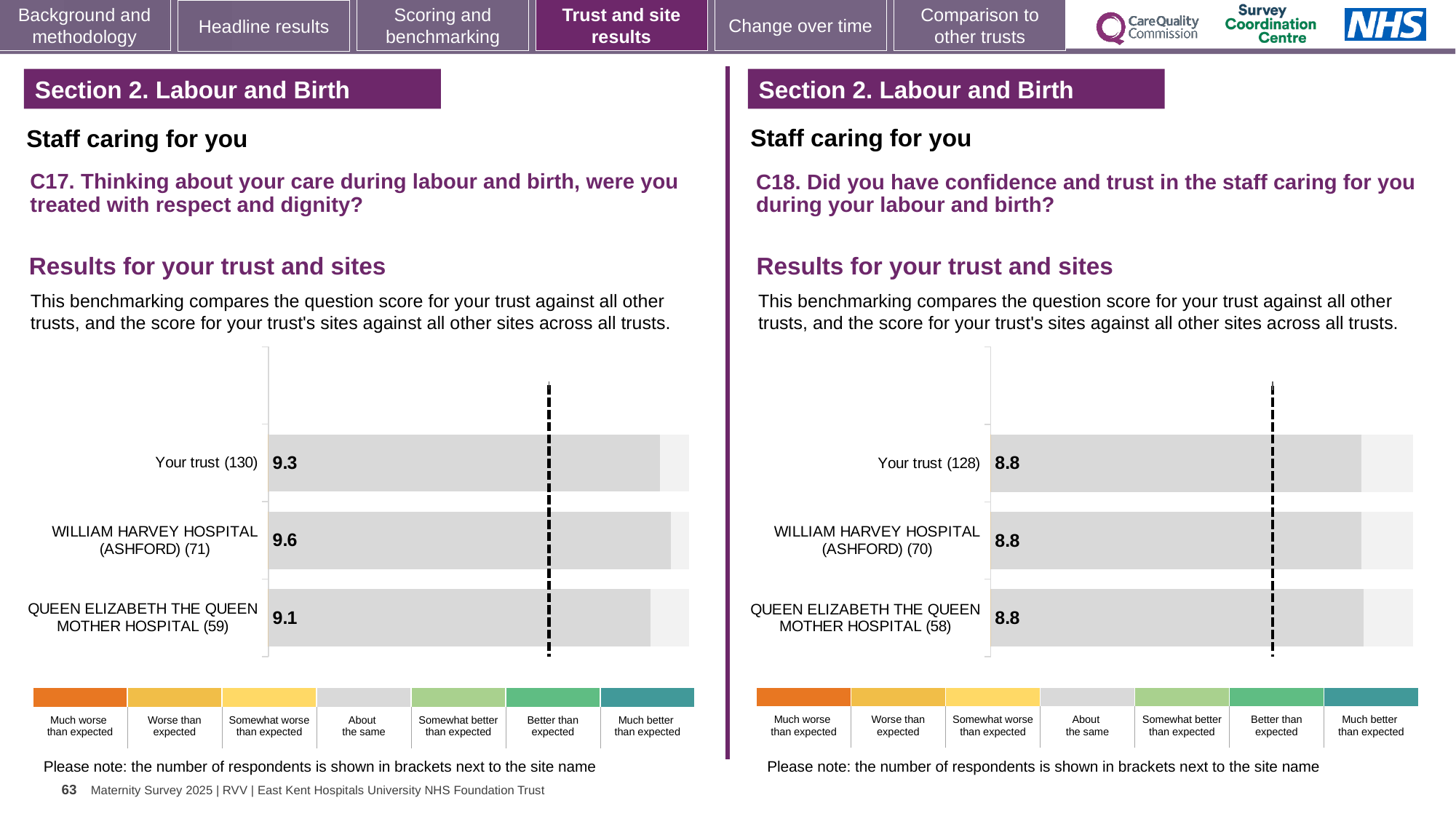
In the C18 chart on the right, how many bars are plotted? 3 In the C17 chart on the left, which site or trust has the highest score? WILLIAM HARVEY HOSPITAL (ASHFORD) (71) In the C18 chart on the right, how many respondents are shown in brackets for WILLIAM HARVEY HOSPITAL (ASHFORD)? 70 In the C17 chart on the left, what is the difference between the scores for WILLIAM HARVEY HOSPITAL (ASHFORD) and QUEEN ELIZABETH THE QUEEN MOTHER HOSPITAL? 0.5 In the C18 chart on the right, what is the score for QUEEN ELIZABETH THE QUEEN MOTHER HOSPITAL (58)? 8.8 In the C17 chart on the left, what is the score for Your trust (130)? 9.3 In the C17 chart on the left, which has the larger score: Your trust or WILLIAM HARVEY HOSPITAL (ASHFORD)? WILLIAM HARVEY HOSPITAL (ASHFORD) In the C17 chart on the left, what is the score for WILLIAM HARVEY HOSPITAL (ASHFORD) (71)? 9.6 In the C17 chart on the left, which site or trust has the lowest score? QUEEN ELIZABETH THE QUEEN MOTHER HOSPITAL (59) In the C18 chart on the right, what is the score for Your trust (128)? 8.8 What kind of chart is the C17 chart on the left? Bar chart In the C17 chart on the left, what is the score for QUEEN ELIZABETH THE QUEEN MOTHER HOSPITAL (59)? 9.1